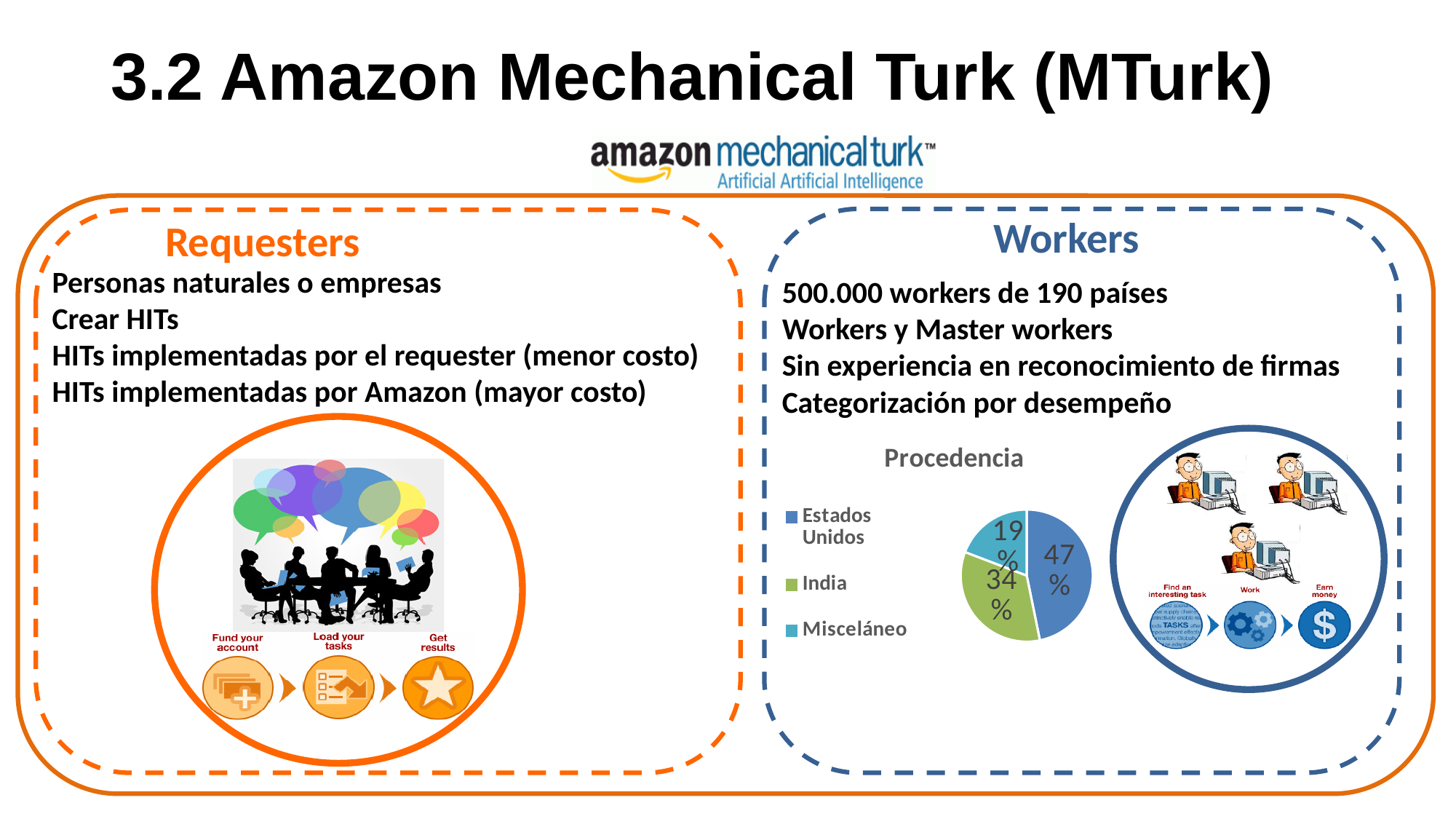
What share of the pie does India have? 34% Which category has the smallest slice of the pie? Misceláneo What is the title of the pie chart? Procedencia Which is larger, the India slice or the Misceláneo slice? India What is the difference between the India and Misceláneo shares? 15% What share of the pie does Misceláneo have? 19% What is the difference between the Estados Unidos and India shares? 13% Which category has the largest slice of the pie? Estados Unidos Which legend entry is shown in green? India What share of the pie does Estados Unidos have? 47% What type of chart is the "Procedencia" chart? pie chart How many categories does the pie chart show? 3